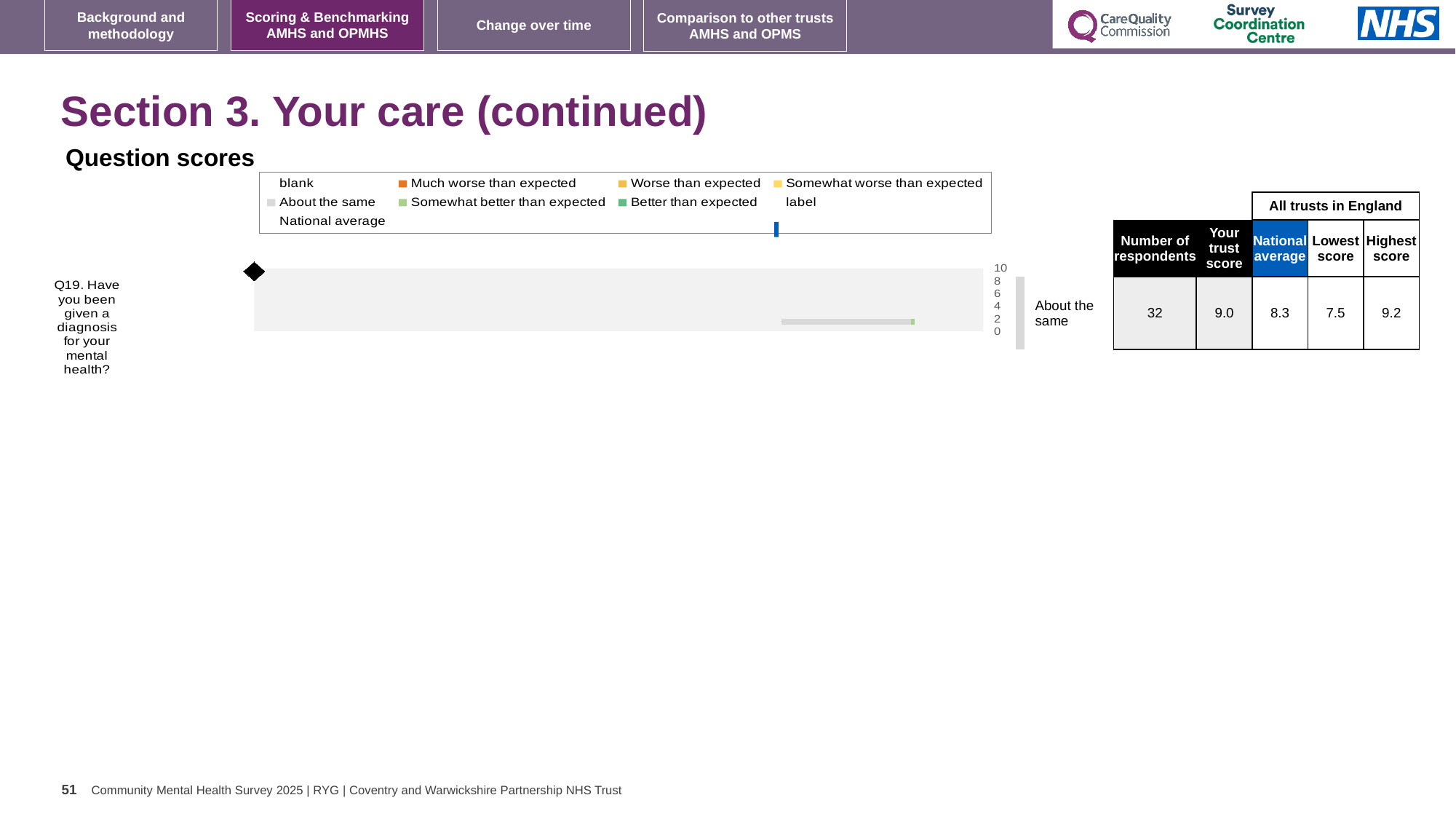
What colour does the legend use for 'Much worse than expected'? orange What is the difference between the highest and lowest scores for Q19 across all trusts in England? 1.7 What is the trust's score for Q19 (Have you been given a diagnosis for your mental health?)? 9.0 What is the national average score for Q19? 8.3 What kind of chart is used to show the Q19 question score? bar chart What benchmark category is shown next to the Q19 bar? About the same For Q19, which is larger: the trust's score or the national average? the trust's score What is the highest score among all trusts in England for Q19? 9.2 What is the lowest score among all trusts in England for Q19? 7.5 How many respondents answered Q19? 32 How many survey questions are plotted on the question scores chart? 1 By how much does the trust's score for Q19 exceed the national average? 0.7